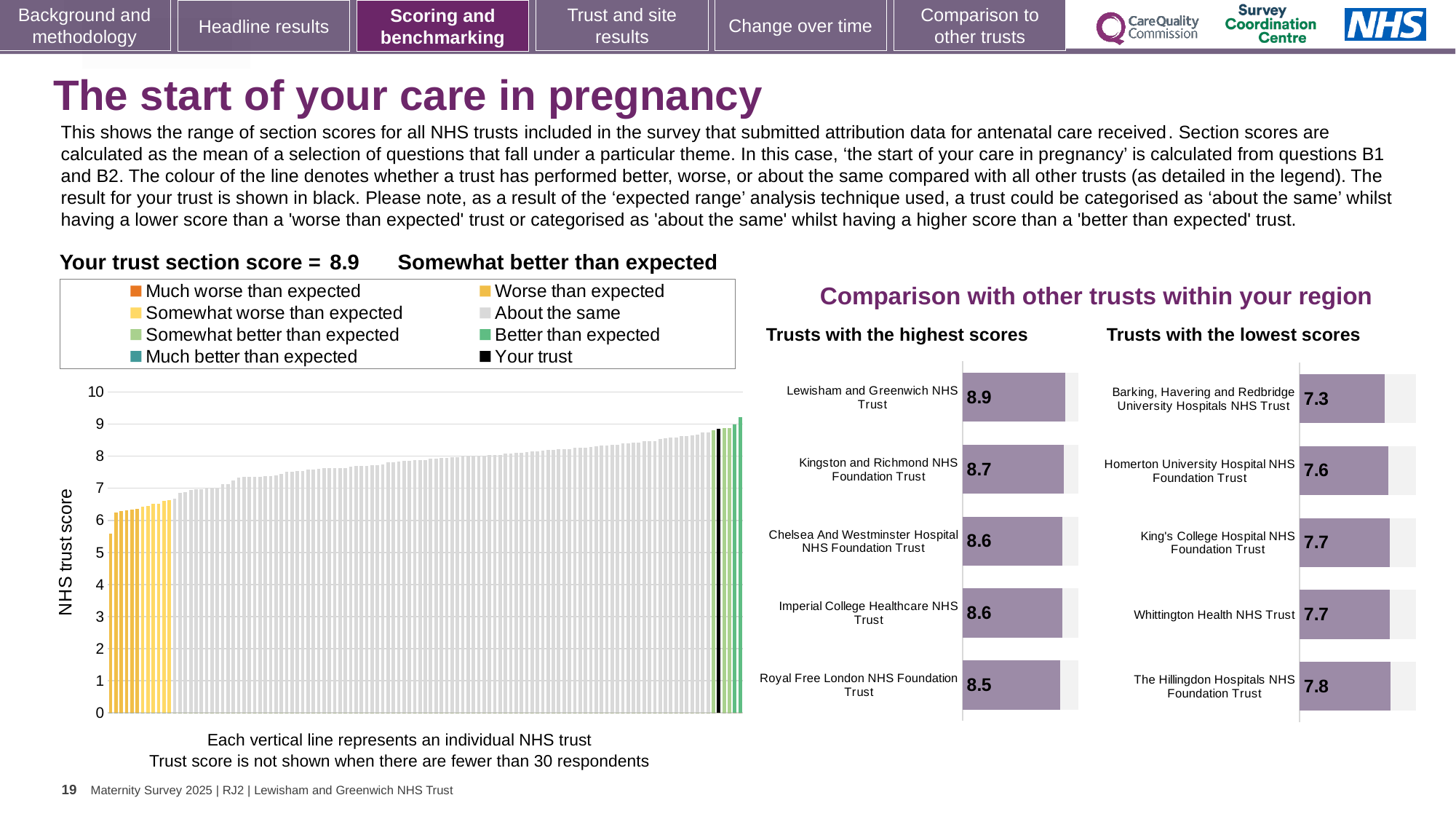
In the 'NHS trust score' chart on the left, is the value of the leftmost bar greater or less than 6? less In the 'NHS trust score' chart on the left, do the bars rise or fall from left to right? Rise In the 'Trusts with the lowest scores' chart, what is the difference between the scores of The Hillingdon Hospitals NHS Foundation Trust and Barking, Havering and Redbridge University Hospitals NHS Trust? 0.5 In the 'Trusts with the highest scores' chart, what is the score for Kingston and Richmond NHS Foundation Trust? 8.7 In the 'Trusts with the lowest scores' chart, which trust has the lowest score? Barking, Havering and Redbridge University Hospitals NHS Trust In the 'Trusts with the lowest scores' chart, what is the score for Homerton University Hospital NHS Foundation Trust? 7.6 What type of chart is the 'NHS trust score' chart on the left of the slide? Bar chart How many entries does the legend above the 'NHS trust score' chart list? 8 In the 'Trusts with the highest scores' chart, what is the difference between the scores of Lewisham and Greenwich NHS Trust and Royal Free London NHS Foundation Trust? 0.4 In the 'Trusts with the lowest scores' chart, which has the higher score: King's College Hospital NHS Foundation Trust or Homerton University Hospital NHS Foundation Trust? King's College Hospital NHS Foundation Trust In the 'Trusts with the highest scores' chart, which trust has the highest score? Lewisham and Greenwich NHS Trust How many trusts are shown in the 'Trusts with the highest scores' chart? 5